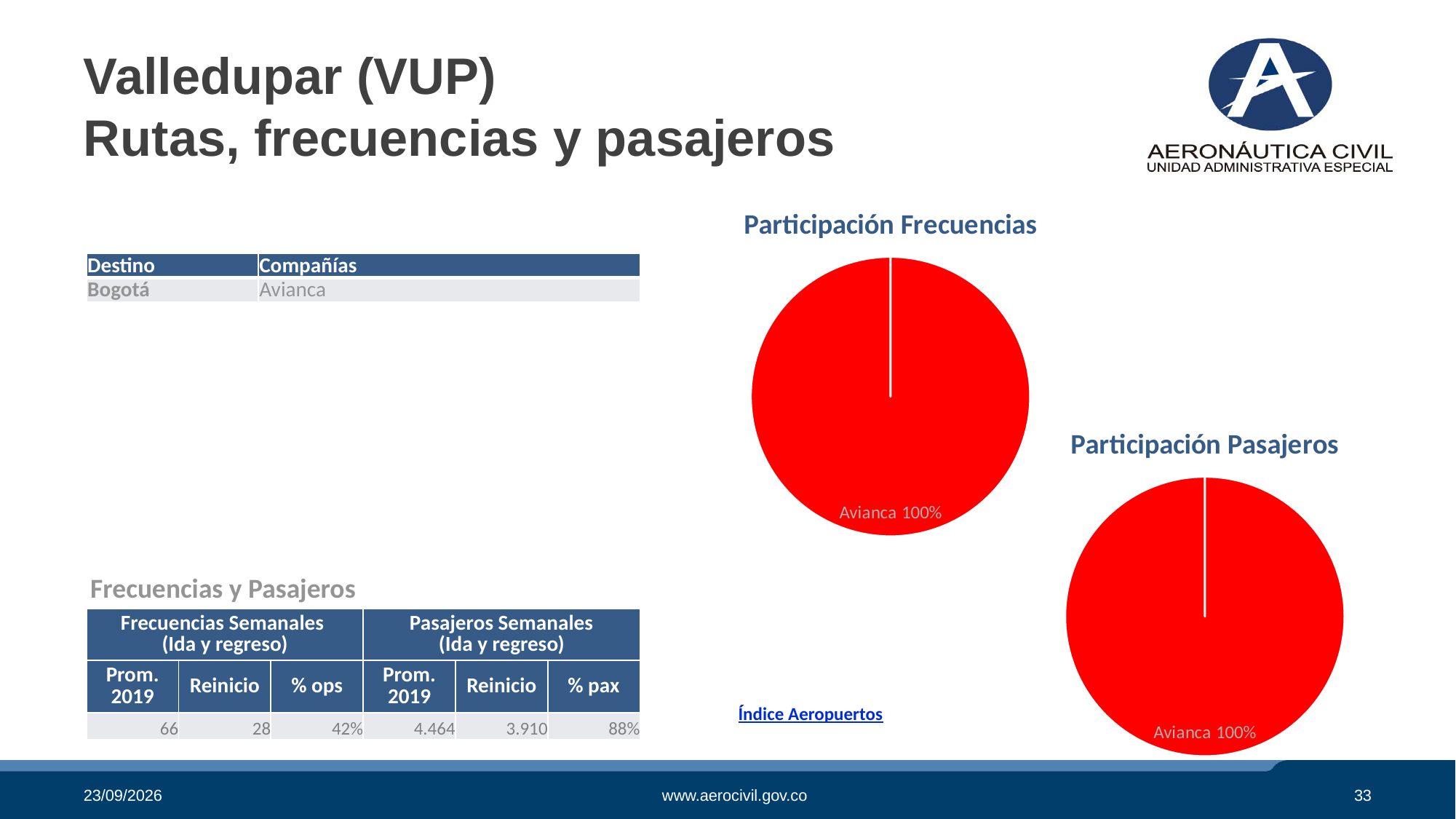
What is the title of the pie chart at the top right of the slide? Participación Frecuencias What kind of chart is 'Participación Pasajeros'? Pie chart In the 'Participación Pasajeros' chart, what share does Avianca have? 100% What colour is the Avianca slice in the 'Participación Pasajeros' chart? Red How many pie charts are on the slide? 2 How many slices does the 'Participación Pasajeros' pie chart have? 1 How many slices does the 'Participación Frecuencias' pie chart have? 1 What kind of chart is 'Participación Frecuencias'? Pie chart In the 'Participación Frecuencias' chart, what share does Avianca have? 100% Which airline is shown in the 'Participación Pasajeros' chart? Avianca Which airline is shown in the 'Participación Frecuencias' chart? Avianca